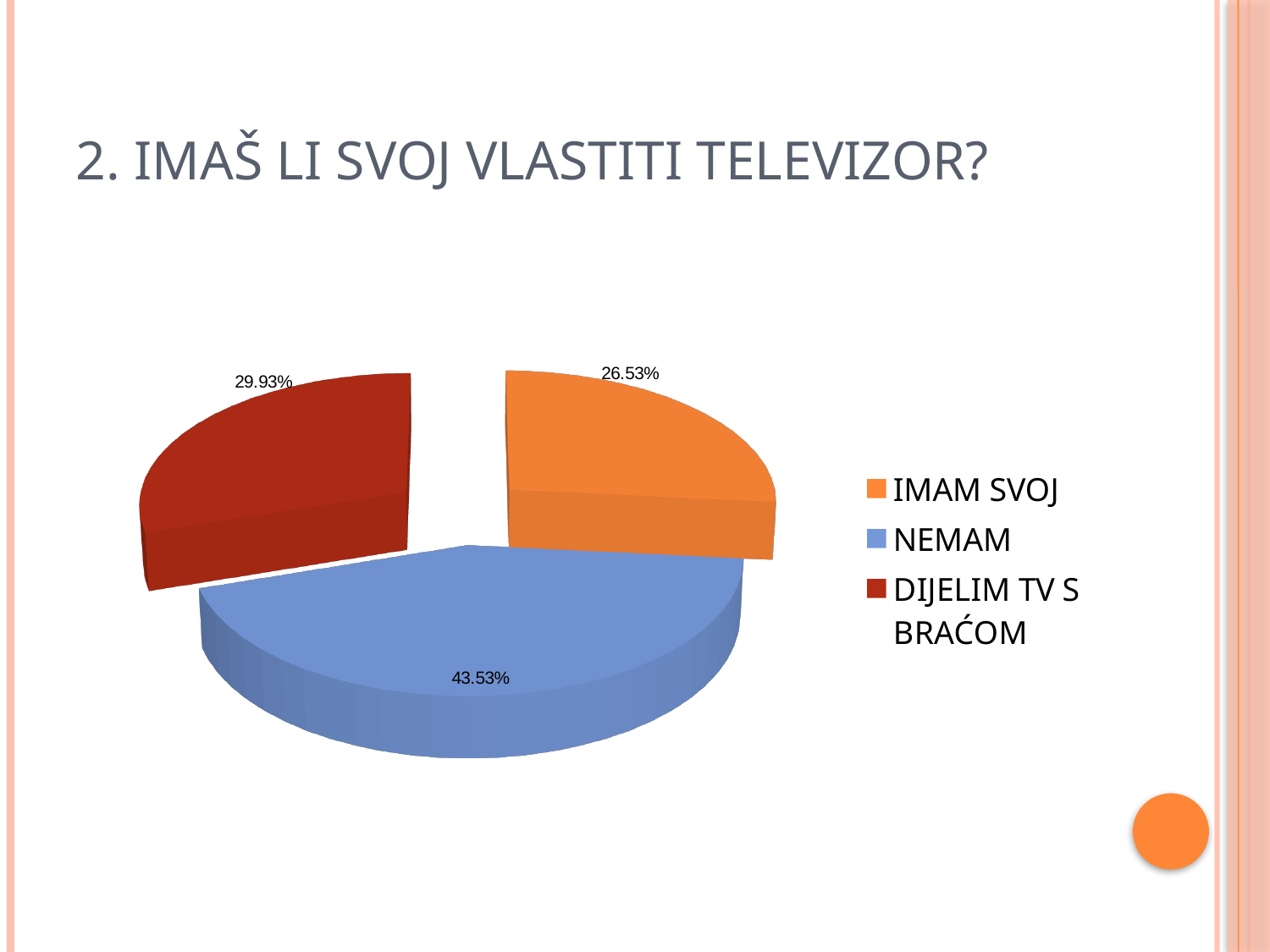
What is the value for DIJELIM TV S BRAĆOM? 29.93% What colour is the NEMAM slice? blue Which category has the smallest share? IMAM SVOJ How many categories does the pie chart have? 3 What is the value for IMAM SVOJ? 26.53% What is the title of the slide? 2. IMAŠ LI SVOJ VLASTITI TELEVIZOR? What is the difference between the values for DIJELIM TV S BRAĆOM and IMAM SVOJ? 3.40% What kind of chart is shown on the slide? pie chart Which is larger, DIJELIM TV S BRAĆOM or IMAM SVOJ? DIJELIM TV S BRAĆOM What is the difference between the values for NEMAM and IMAM SVOJ? 17.00% Which category has the largest share? NEMAM What is the value for NEMAM? 43.53%